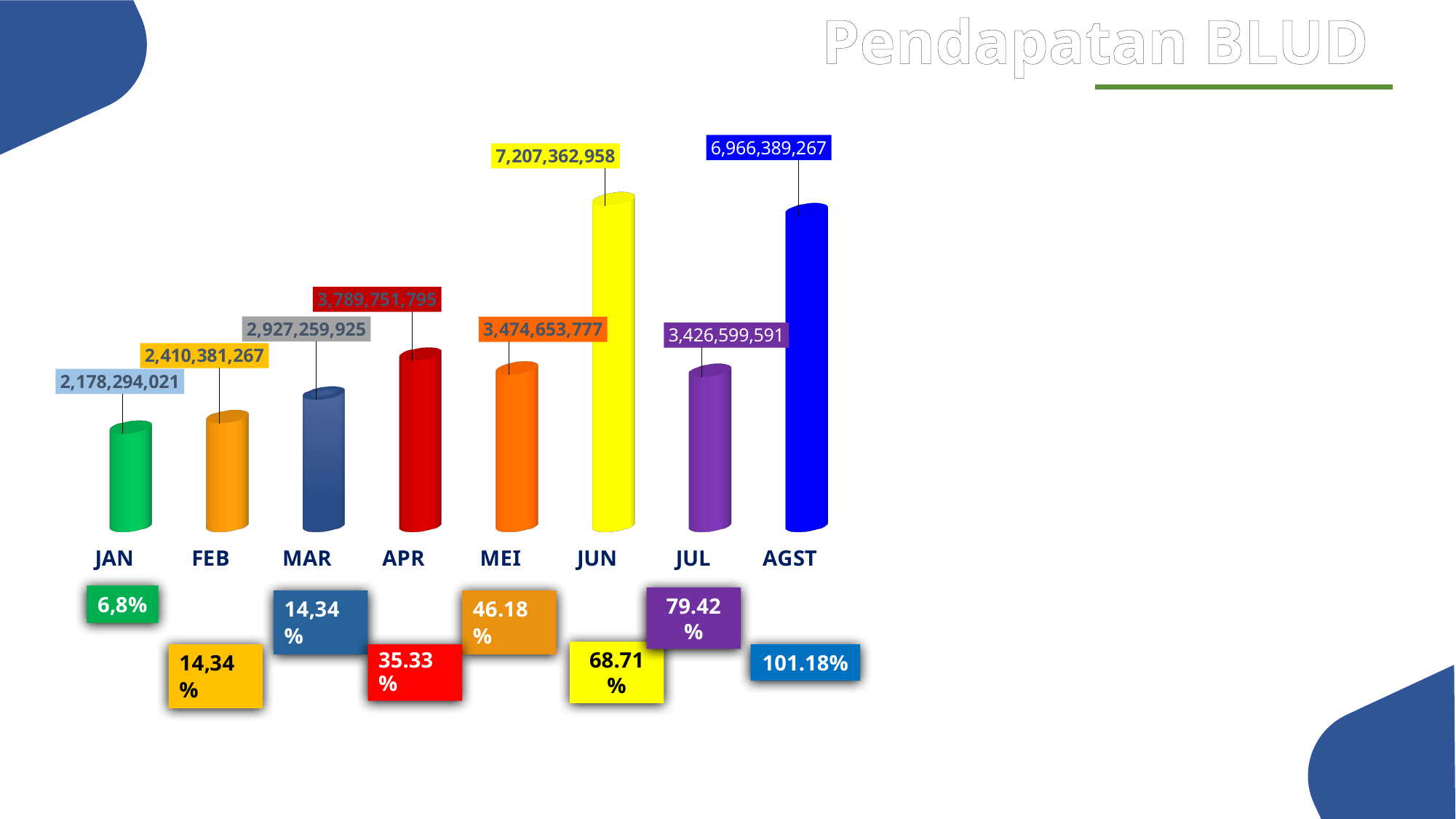
Which month has the lowest value? JAN What is the value for JUN? 7,207,362,958 What is the difference between the values for APR and MEI? 315,098,018 Which is larger, the value for APR or the value for MAR? APR How many months are shown on the chart? 8 What is the title of the slide containing the chart? Pendapatan BLUD What is the difference between the values for JUN and AGST? 240,973,691 What is the value for JUL? 3,426,599,591 Which month has the highest value? JUN What is the value for JAN? 2,178,294,021 What kind of chart is shown on the slide? Bar chart What is the value for AGST? 6,966,389,267